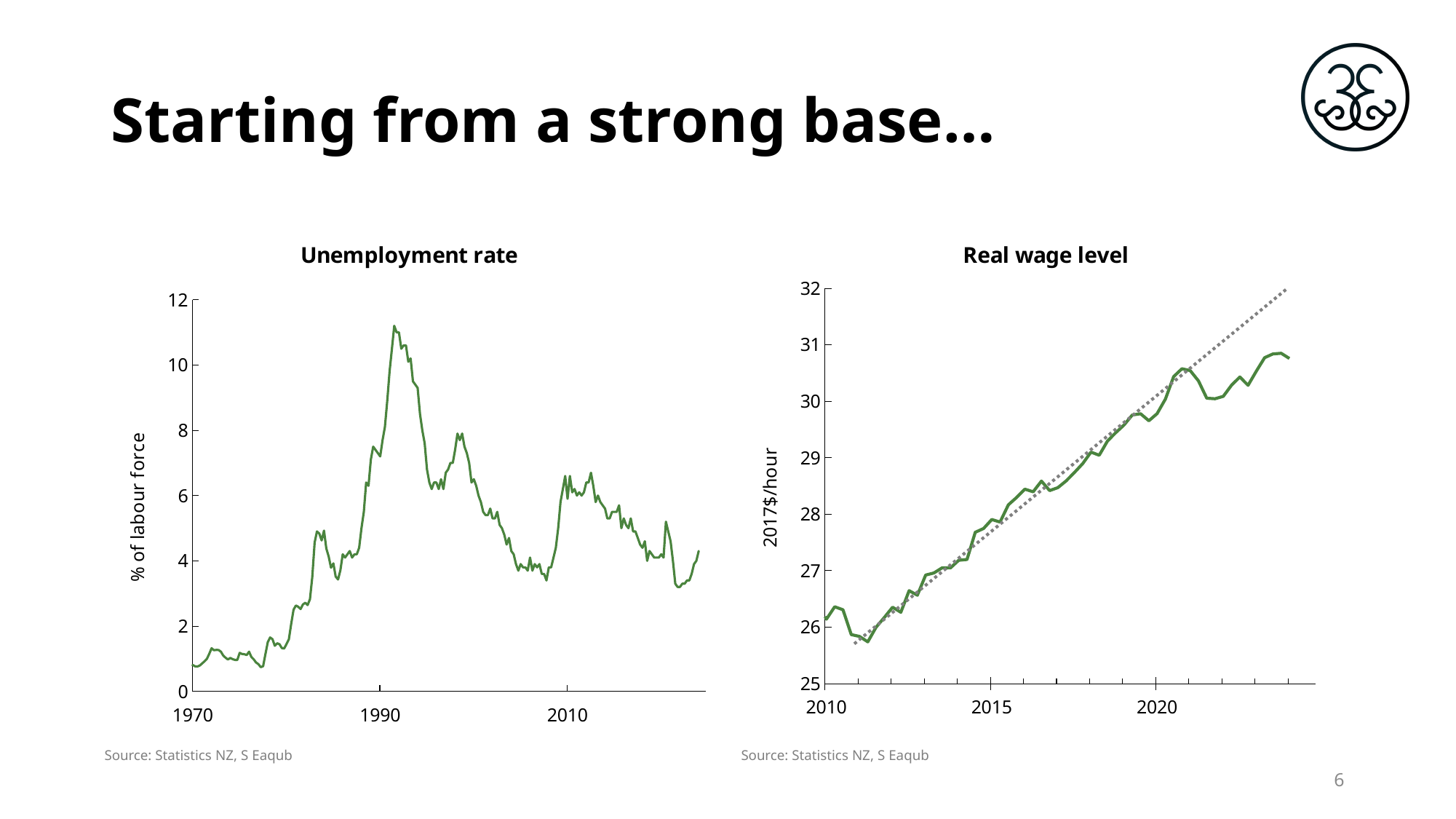
What is the y-axis label of the 'Unemployment rate' chart? % of labour force In the 'Unemployment rate' chart, is the peak value reached in the early 1990s greater or less than 10? greater In the 'Real wage level' chart, is the value in 2010 greater or less than 27? less In the 'Real wage level' chart, is the final value of the solid line greater or less than 31? less What is the y-axis label of the 'Real wage level' chart? 2017$/hour What kind of chart is the 'Unemployment rate' chart? line chart In the 'Real wage level' chart, does the solid line generally rise or fall from 2010 to the end of the series? rise In the 'Unemployment rate' chart, does the line rise or fall between 1970 and the early 1990s peak? rise What kind of chart is the 'Real wage level' chart? line chart